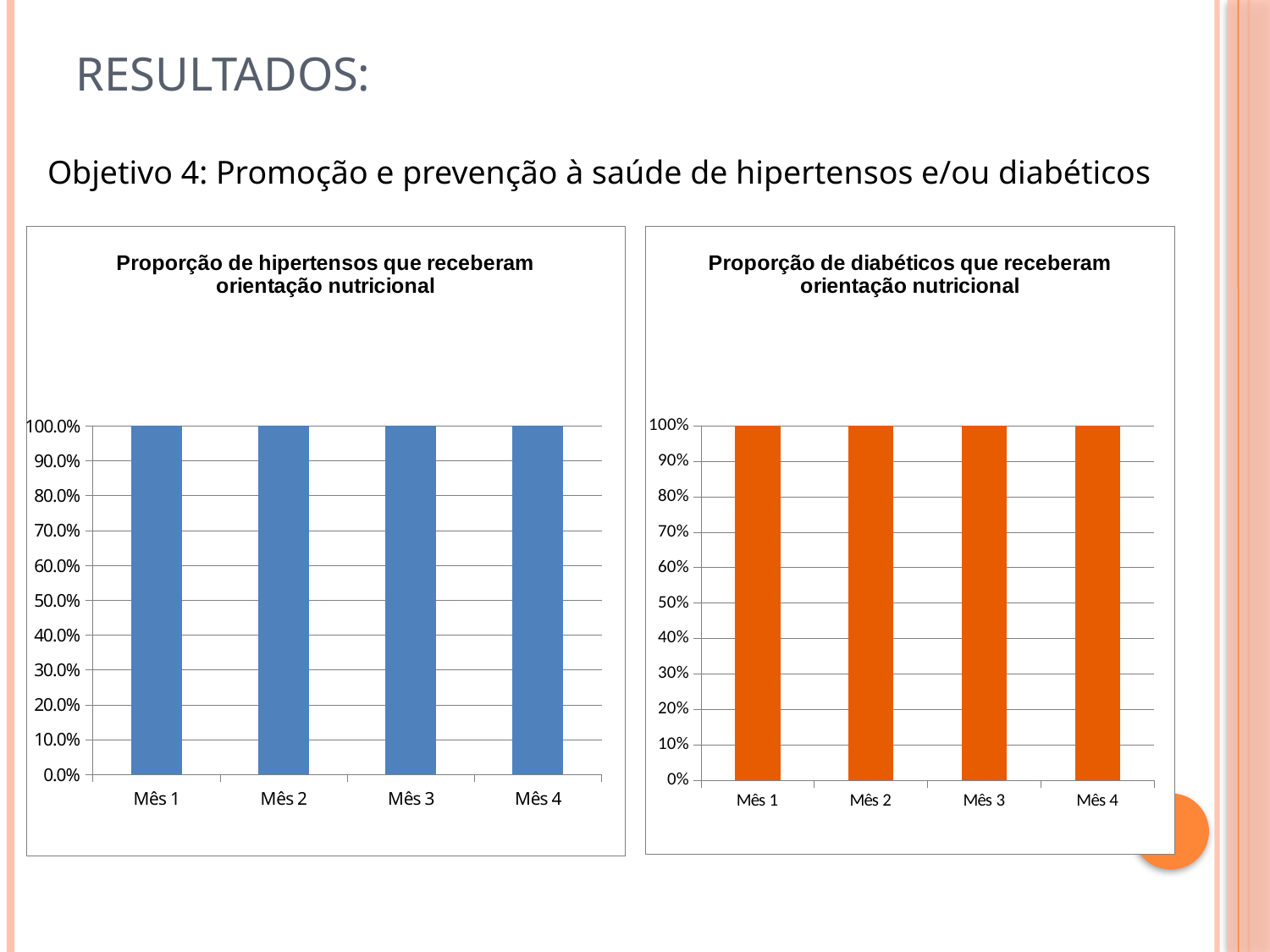
In the left chart, is the value for Mês 2 greater or less than 90.0%? greater What colour are the bars in the chart titled 'Proporção de diabéticos que receberam orientação nutricional'? Orange In the right chart, is the value for Mês 4 greater or less than 50%? greater In the chart titled 'Proporção de diabéticos que receberam orientação nutricional', do the values rise, fall or stay the same from Mês 1 to Mês 4? Stay the same How many bars are plotted in the right chart? 4 In the chart titled 'Proporção de hipertensos que receberam orientação nutricional', what is the value for Mês 4? 100.0% What kind of chart is the chart on the right of the slide? Bar chart In the chart titled 'Proporção de diabéticos que receberam orientação nutricional', what is the value for Mês 2? 100% What kind of chart is the chart titled 'Proporção de hipertensos que receberam orientação nutricional'? Bar chart In the chart titled 'Proporção de hipertensos que receberam orientação nutricional', what is the value for Mês 1? 100.0% How many categories are shown on the x axis of the left chart? 4 In the chart titled 'Proporção de diabéticos que receberam orientação nutricional', what is the value for Mês 3? 100%